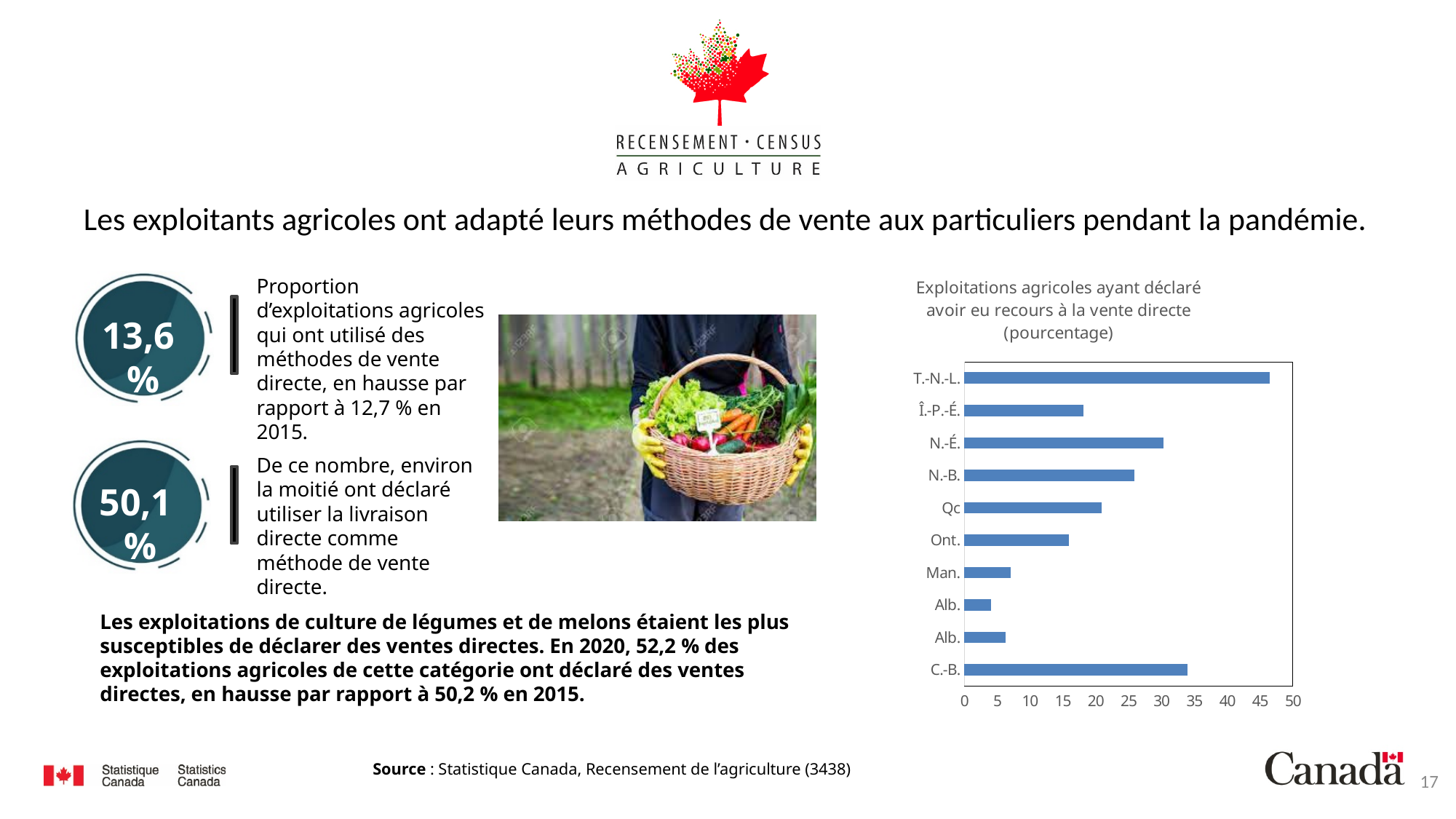
What is the title of the chart? Exploitations agricoles ayant déclaré avoir eu recours à la vente directe (pourcentage) Which category has the highest value in the chart? T.-N.-L. Is the value for Ont. greater or less than 20? less Is the value for C.-B. greater or less than 30? greater Which has a larger value, Qc or Ont.? Qc How many categories (bars) does the chart show? 10 Which has a larger value, C.-B. or N.-É.? C.-B. What is the maximum value shown on the chart's horizontal axis? 50 Is the value for T.-N.-L. greater or less than 40? greater What kind of chart is shown on the slide? bar chart